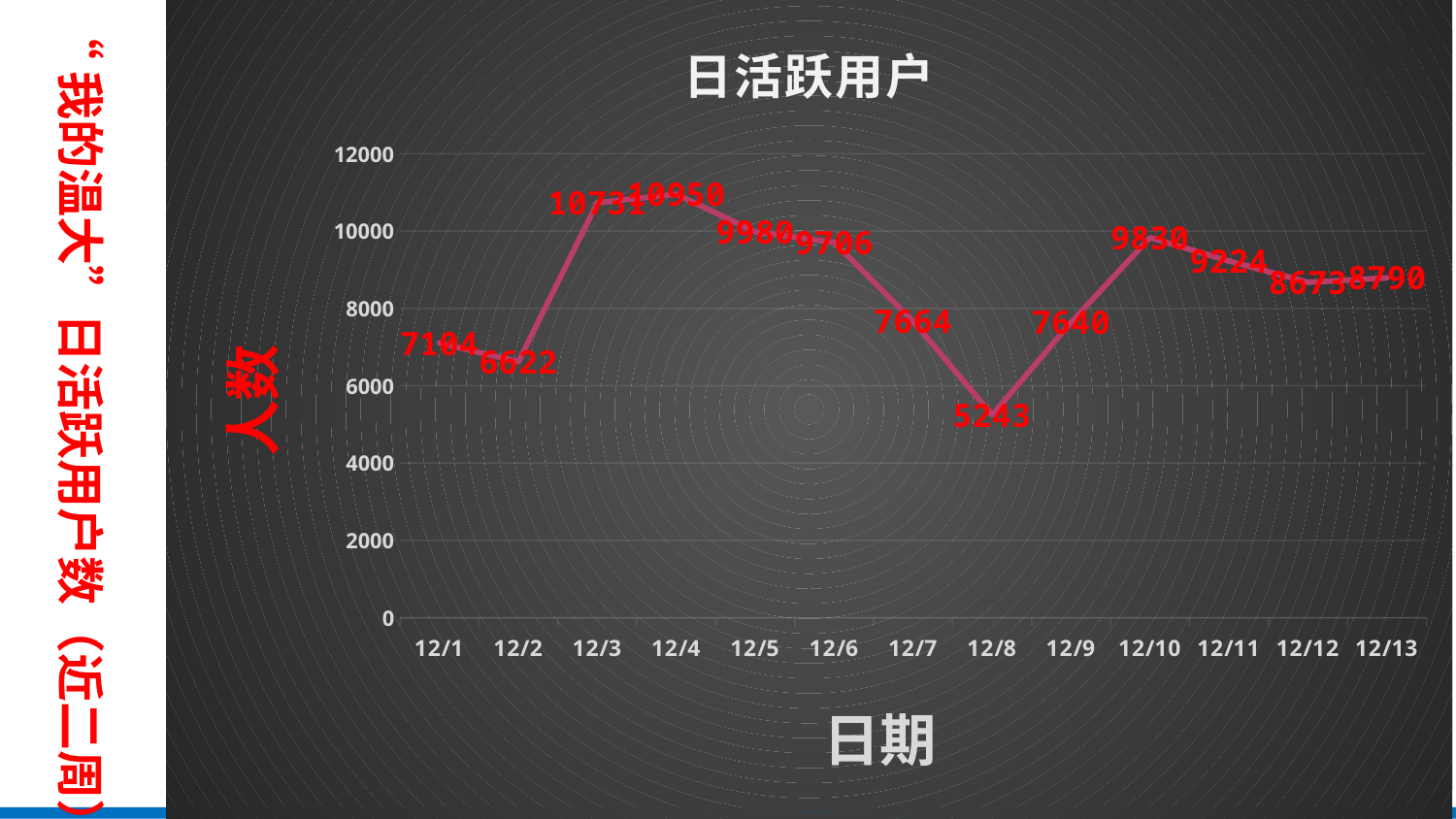
What kind of chart is the 日活跃用户 chart? line chart What is the value for 12/4 in the 日活跃用户 chart? 10950 What is the difference between the values for 12/10 and 12/9 in the 日活跃用户 chart? 2190 Which is larger in the 日活跃用户 chart, the value for 12/12 or 12/13? 12/13 What is the difference between the values for 12/4 and 12/3 in the 日活跃用户 chart? 219 Do the values in the 日活跃用户 chart rise or fall from 12/4 to 12/8? fall What is the value for 12/1 in the 日活跃用户 chart? 7104 Which date has the highest value in the 日活跃用户 chart? 12/4 Is the value for 12/8 in the 日活跃用户 chart greater or less than 6000? less Which date has the lowest value in the 日活跃用户 chart? 12/8 What is the value for 12/8 in the 日活跃用户 chart? 5243 How many dates are plotted in the 日活跃用户 chart? 13